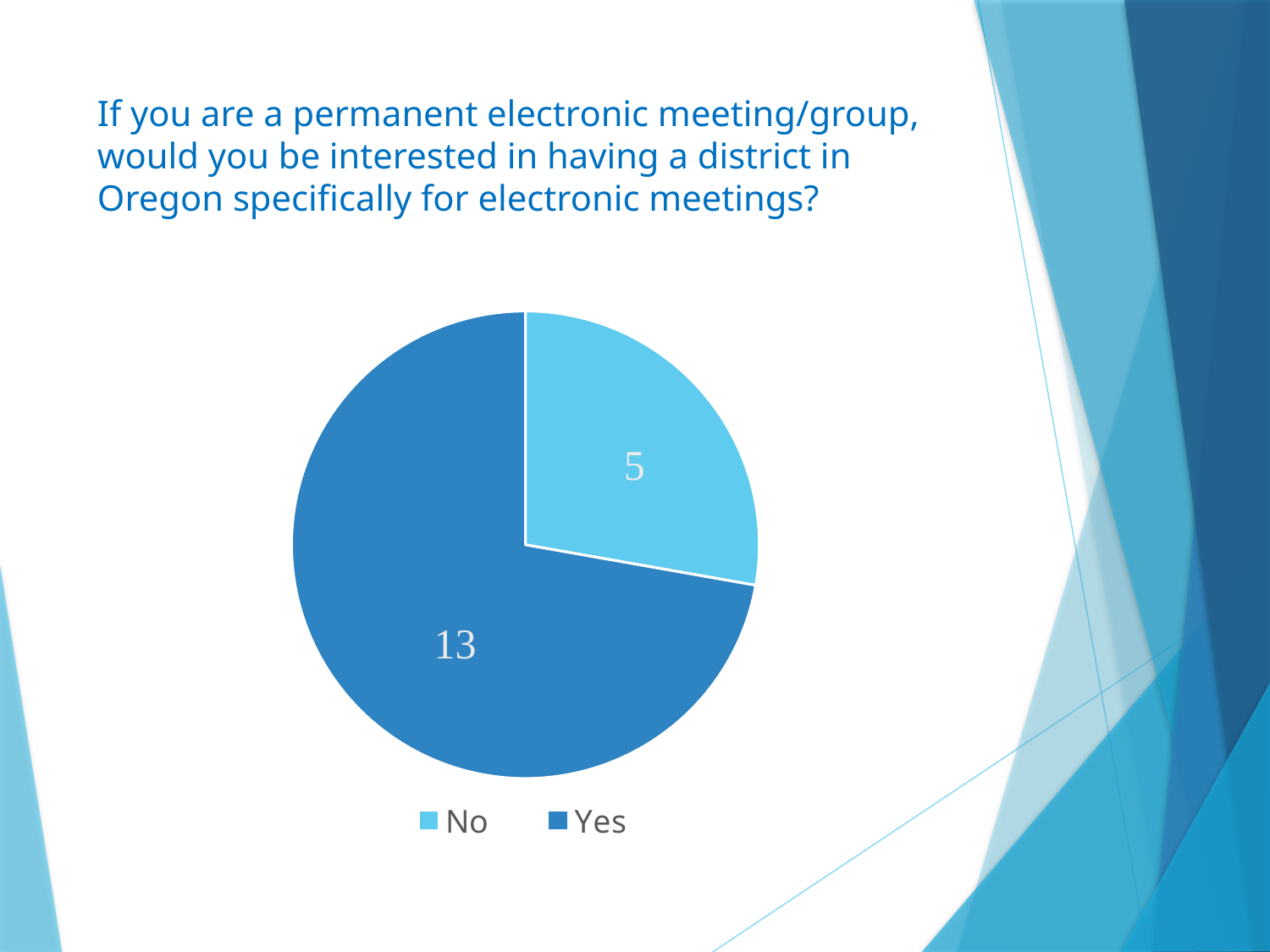
Is the value for Yes larger or smaller than the value for No? larger What kind of chart is shown on the slide? pie chart What is the difference between the Yes and No counts? 8 How many responses are labelled "Yes" in the pie chart? 13 Which response has the larger slice of the pie, Yes or No? Yes How many responses are labelled "No" in the pie chart? 5 What entries does the legend list? No, Yes Which response has the smaller slice of the pie? No Which legend entry is shown in the lighter blue colour? No What is the total of all slices in the pie chart? 18 How many slices does the pie chart have? 2